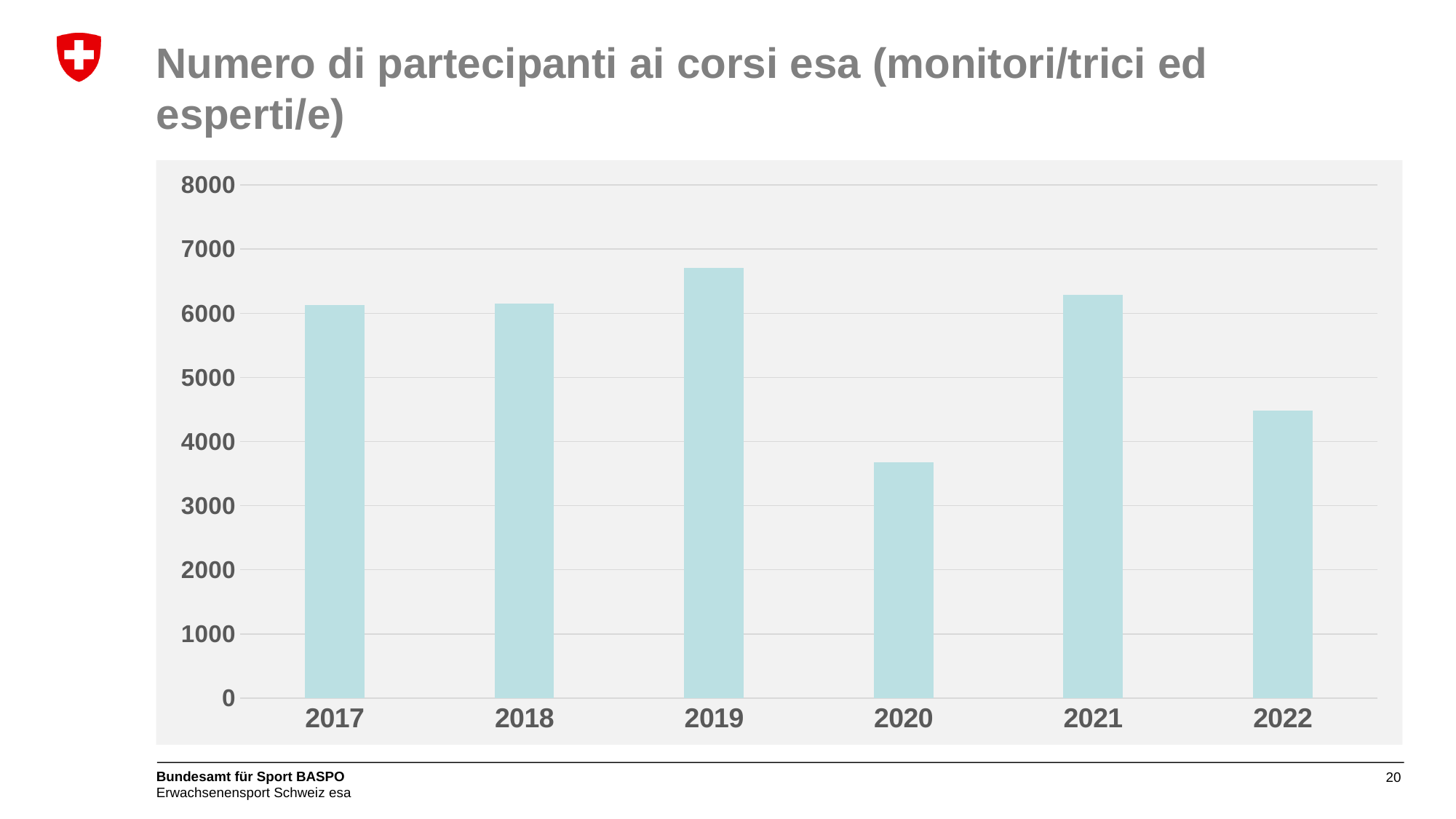
Which is larger, the value for 2020 or the value for 2022? 2022 Is the value for 2019 greater or less than 6000? greater Which year has the highest number of participants? 2019 How many years are shown on the x axis of the chart? 6 Is the value for 2020 greater or less than 4000? less Which year has the lowest number of participants? 2020 Is the value for 2021 greater or less than 6000? greater Did the number of participants rise or fall from 2019 to 2020? fall What kind of chart is shown on the slide? bar chart Which is larger, the value for 2021 or the value for 2022? 2021 What is the title of the slide containing the chart? Numero di partecipanti ai corsi esa (monitori/trici ed esperti/e)